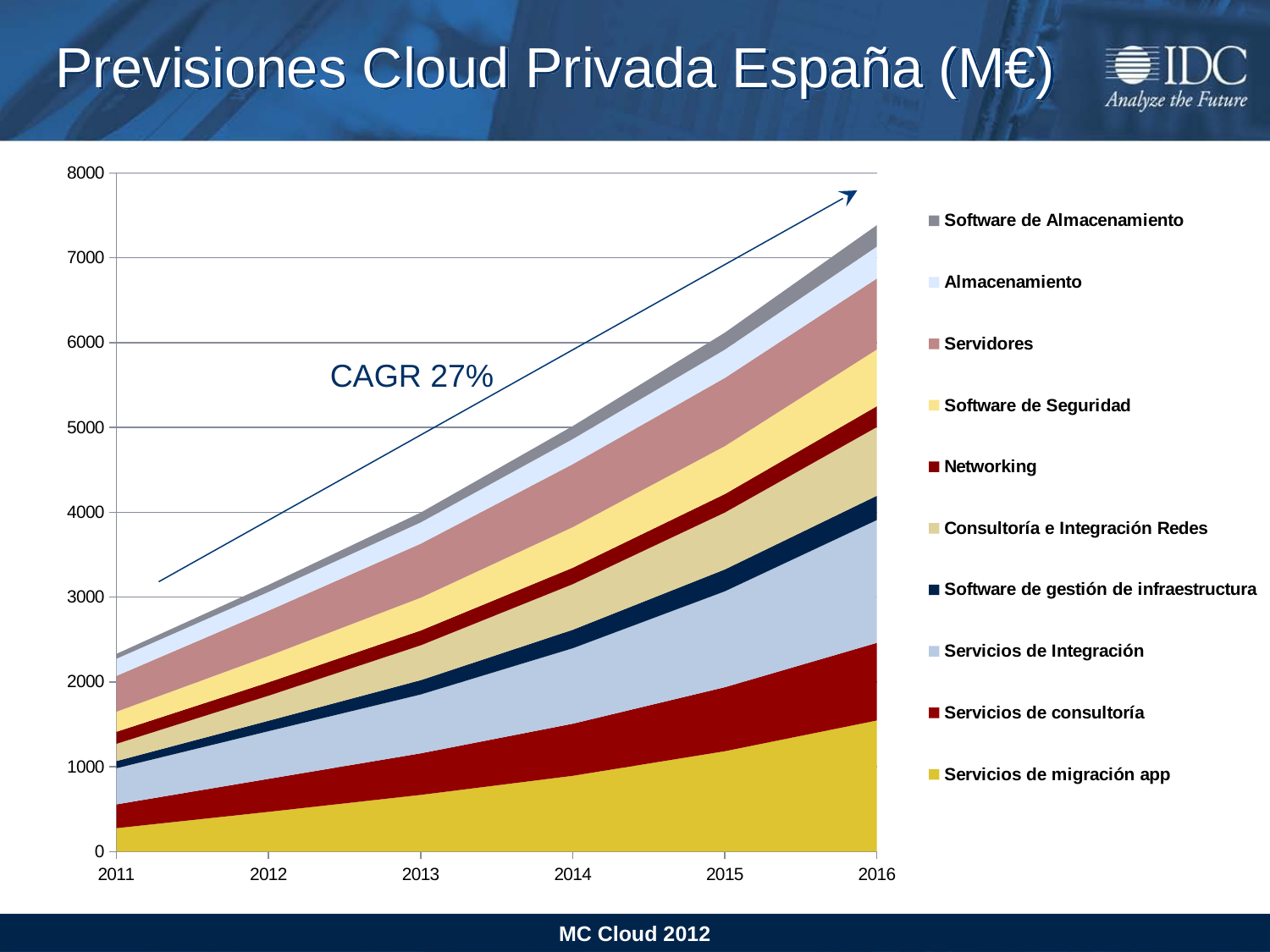
Does the total value rise or fall from 2011 to 2016? Rise How many years are shown along the x axis? 6 What is the title of the slide? Previsiones Cloud Privada España (M€) What kind of chart is shown on the slide? Stacked area chart Which year has the lowest total value? 2011 Is the total value for 2015 greater or less than 5000? greater Is the value for Servicios de migración app in 2016 greater or less than 1000? greater What CAGR is annotated on the chart? 27% How many series does the legend list? 10 Is the total value for 2016 greater or less than 7000? greater Which year has the highest total value? 2016